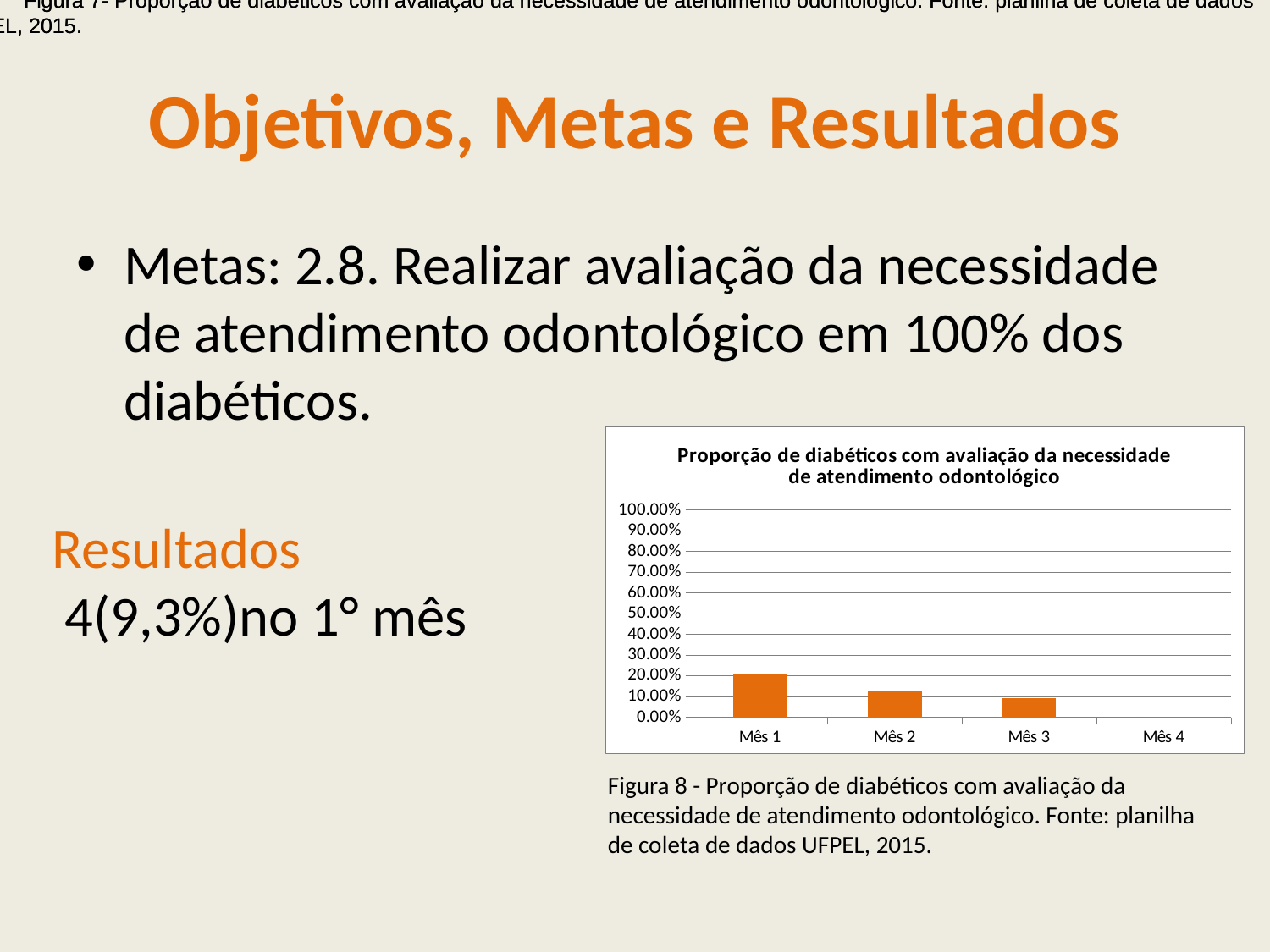
Which month has the lowest proportion in the chart? Mês 4 Which is larger, the value for Mês 2 or the value for Mês 3? Mês 2 What kind of chart is shown on the slide? bar chart Which is larger, the value for Mês 1 or the value for Mês 2? Mês 1 Is the value for Mês 3 greater or less than 20.00%? less How many categories are shown on the x axis of the chart? 4 Is the value for Mês 1 greater or less than 10.00%? greater Which month has the highest proportion in the chart? Mês 1 What is the title of the chart? Proporção de diabéticos com avaliação da necessidade de atendimento odontológico Do the values rise or fall from Mês 1 to Mês 4? fall What is the highest value shown on the y axis of the chart? 100.00% Is the value for Mês 1 greater or less than 30.00%? less